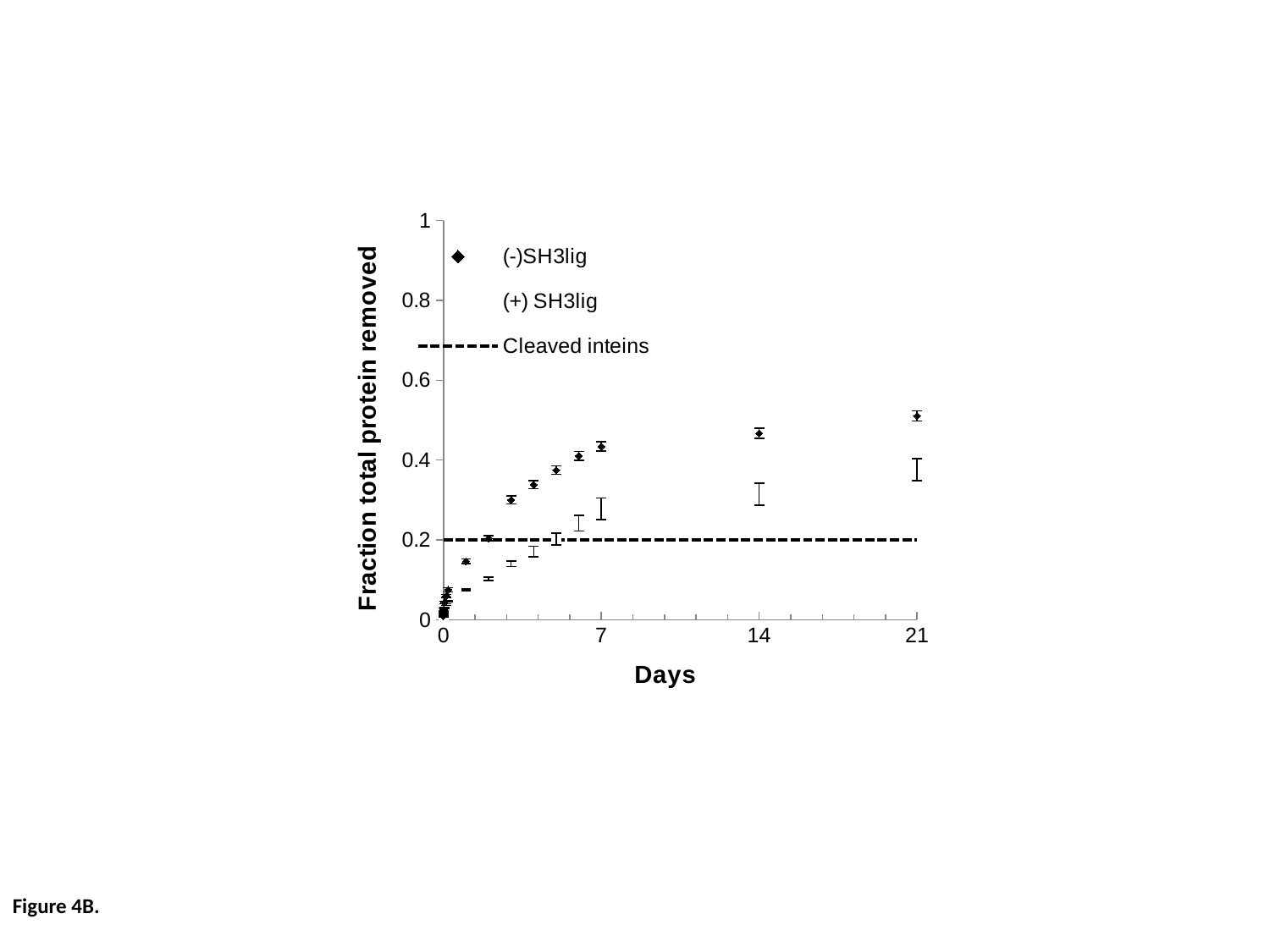
Is the value for (-)SH3lig at day 14 greater or less than 0.4? greater Is the value for (+) SH3lig at day 14 greater or less than 0.4? less At what y-axis value does the dashed Cleaved inteins line sit? 0.2 At day 14, which series has the higher value, (-)SH3lig or (+) SH3lig? (-)SH3lig What kind of chart is shown on the slide? scatter chart Do the (-)SH3lig values rise or fall as the number of days increases? rise What is the title of the x axis? Days What is the title of the y axis? Fraction total protein removed Is the value for (-)SH3lig at day 21 greater or less than 0.4? greater At day 21, which series has the higher value, (-)SH3lig or (+) SH3lig? (-)SH3lig How many series does the legend list? 3